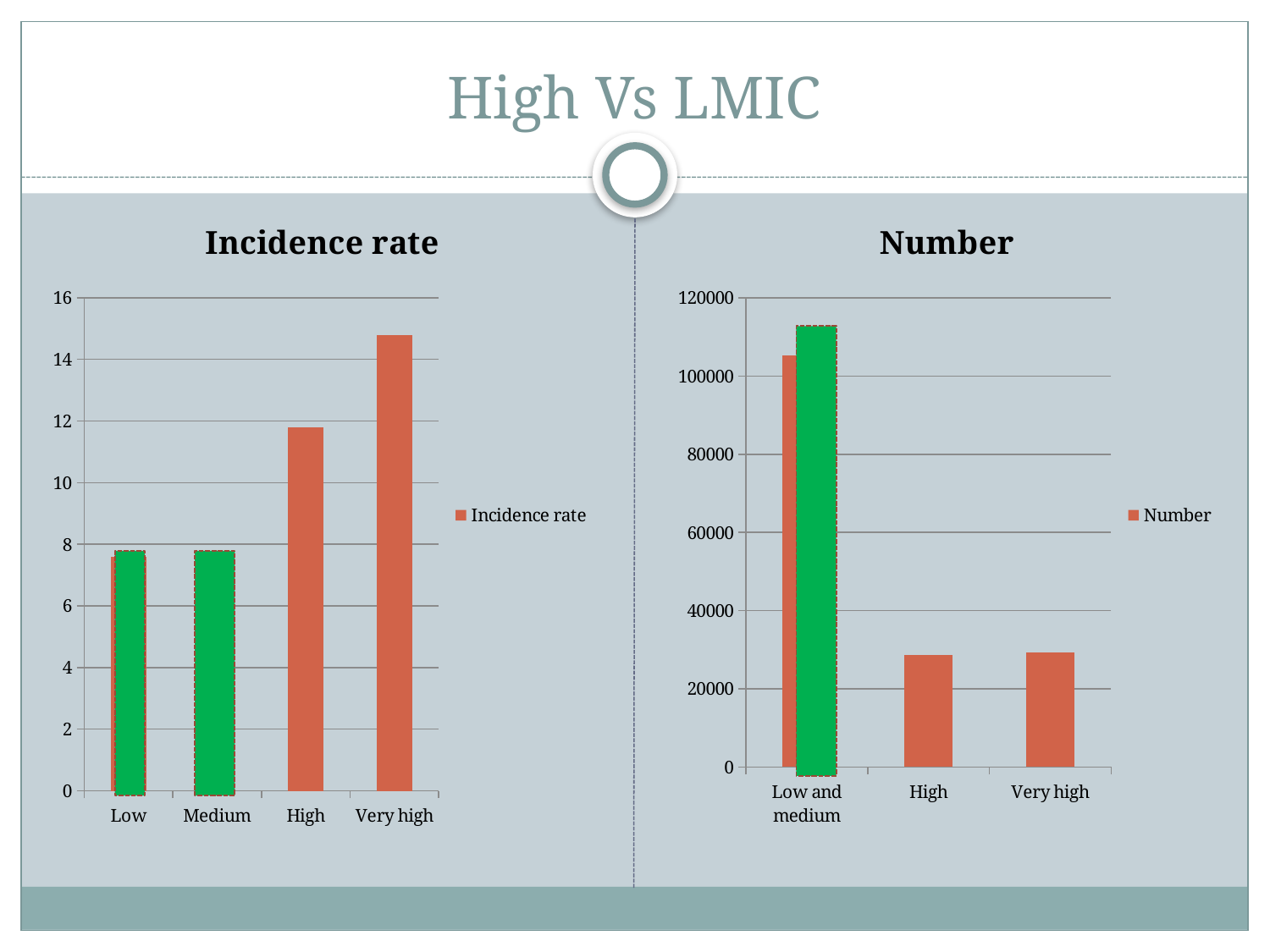
In the "Incidence rate" chart, do the values generally rise or fall from Low to Very high? rise In the "Number" chart, is the value for Low and medium greater or less than 100000? greater In the "Incidence rate" chart, which is larger, the value for High or the value for Very high? Very high In the "Incidence rate" chart, is the value for High greater or less than 10? greater In the "Incidence rate" chart, which category has the highest value? Very high In the "Incidence rate" chart, what kind of chart is shown? bar chart In the "Number" chart, which category has the highest value? Low and medium In the "Number" chart, how many series does the legend list? 1 In the "Number" chart, is the value for High greater or less than 40000? less In the "Incidence rate" chart, how many categories are shown on the x axis? 4 In the "Number" chart, how many categories are shown on the x axis? 3